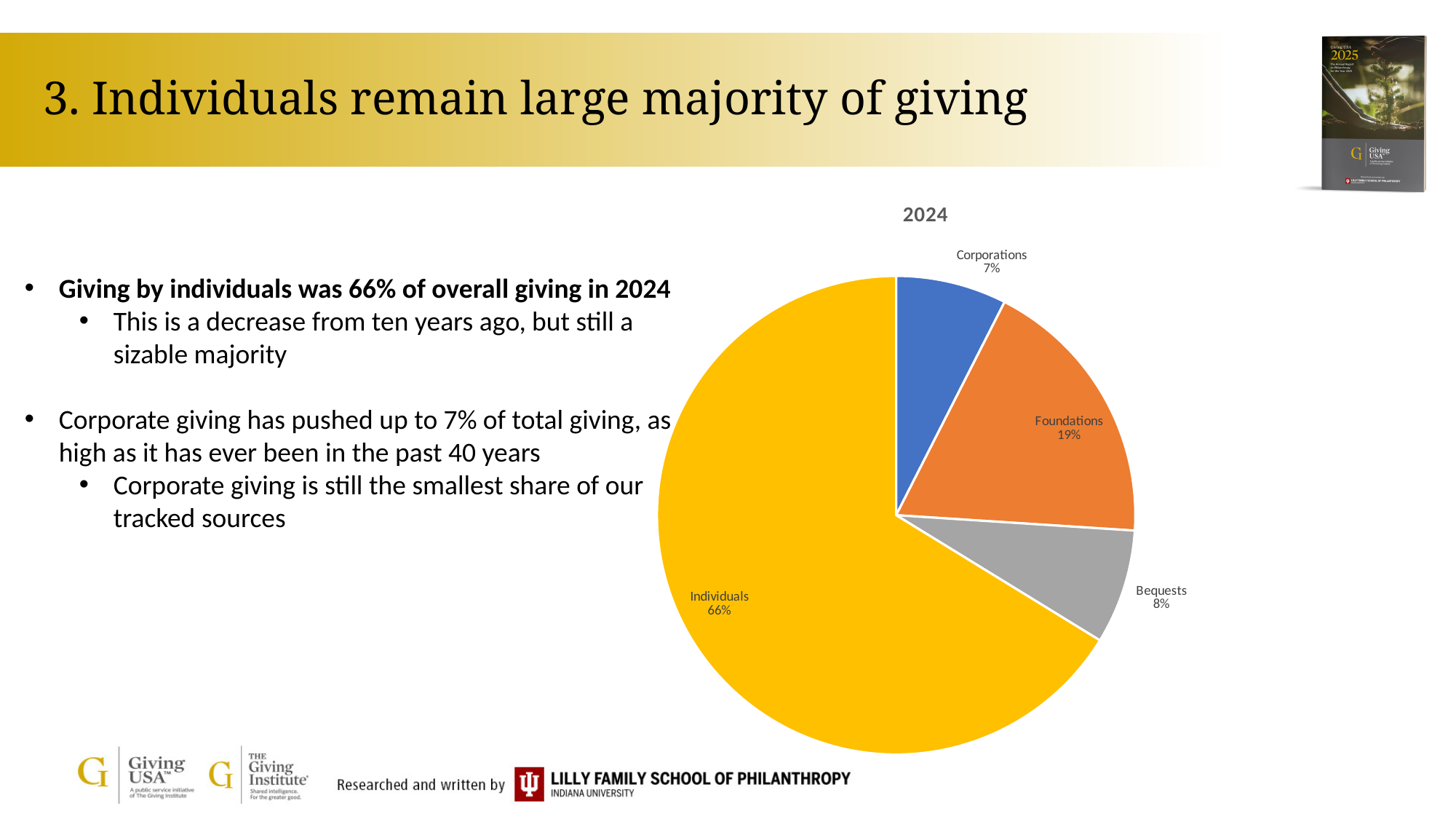
Which slice is larger, Foundations or Bequests? Foundations What share of the pie does Individuals hold? 66% What share of the pie does Bequests hold? 8% What share of the pie does Corporations hold? 7% Which category has the largest slice of the pie? Individuals What kind of chart is shown on the slide? Pie chart What is the difference in percentage points between the Individuals and Foundations slices? 47 Which category has the smallest slice of the pie? Corporations What is the difference in percentage points between the Bequests and Corporations slices? 1 What is the title of the chart? 2024 How many categories are shown in the pie chart? 4